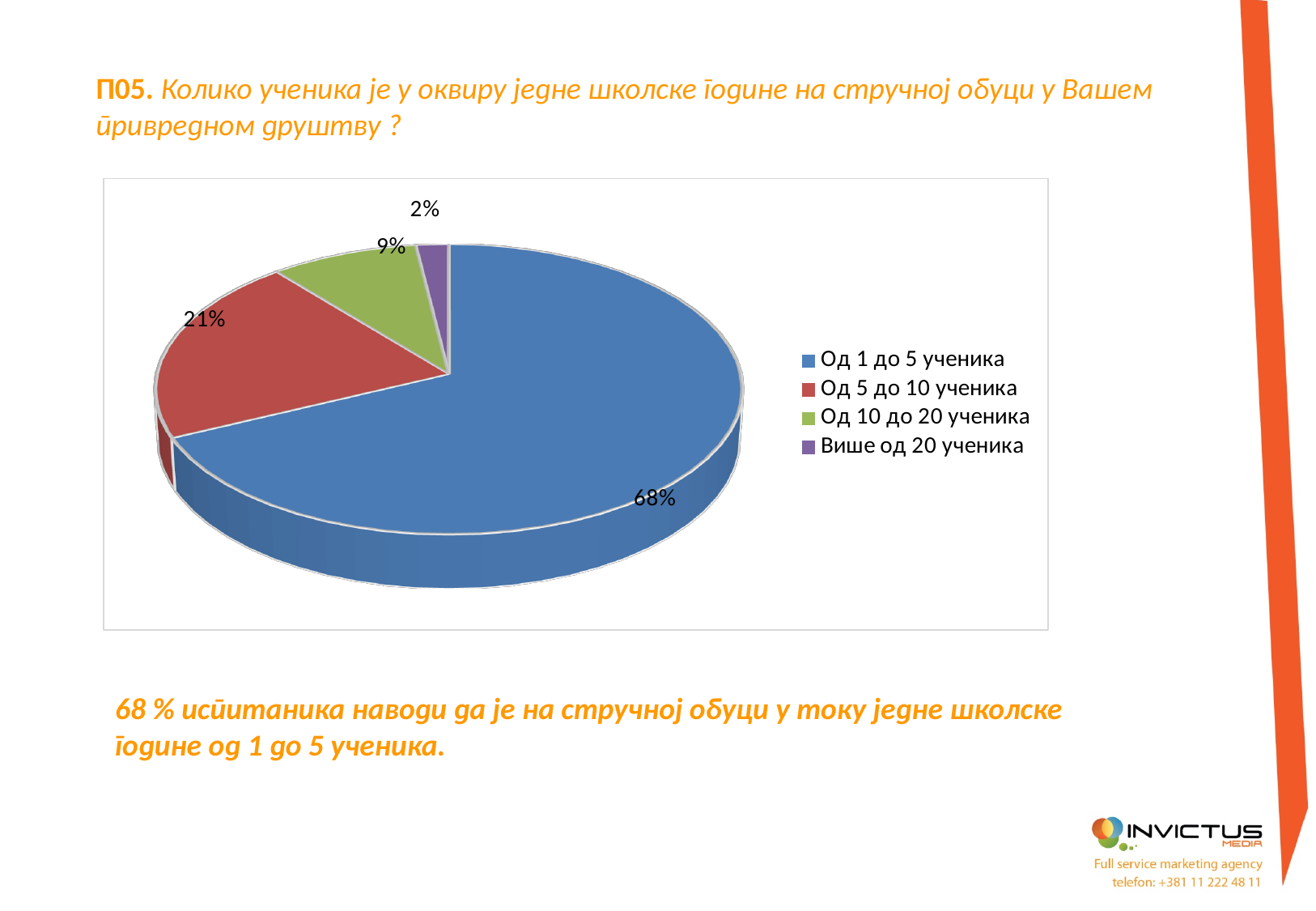
What colour is the slice for 'Од 5 до 10 ученика'? Red What is the value shown for 'Више од 20 ученика'? 2% What is the difference between the shares for 'Од 1 до 5 ученика' and 'Од 5 до 10 ученика'? 47% What share of the pie does the 'Од 1 до 5 ученика' slice represent? 68% Which category has the smallest slice of the pie? Више од 20 ученика Which category has the largest slice of the pie? Од 1 до 5 ученика What kind of chart is shown on the slide? Pie chart Which is larger: the share for 'Од 10 до 20 ученика' or for 'Више од 20 ученика'? Од 10 до 20 ученика What is the value shown for 'Од 10 до 20 ученика'? 9% How many entries does the legend list? 4 How many categories are shown in the pie chart? 4 What is the value shown for 'Од 5 до 10 ученика'? 21%